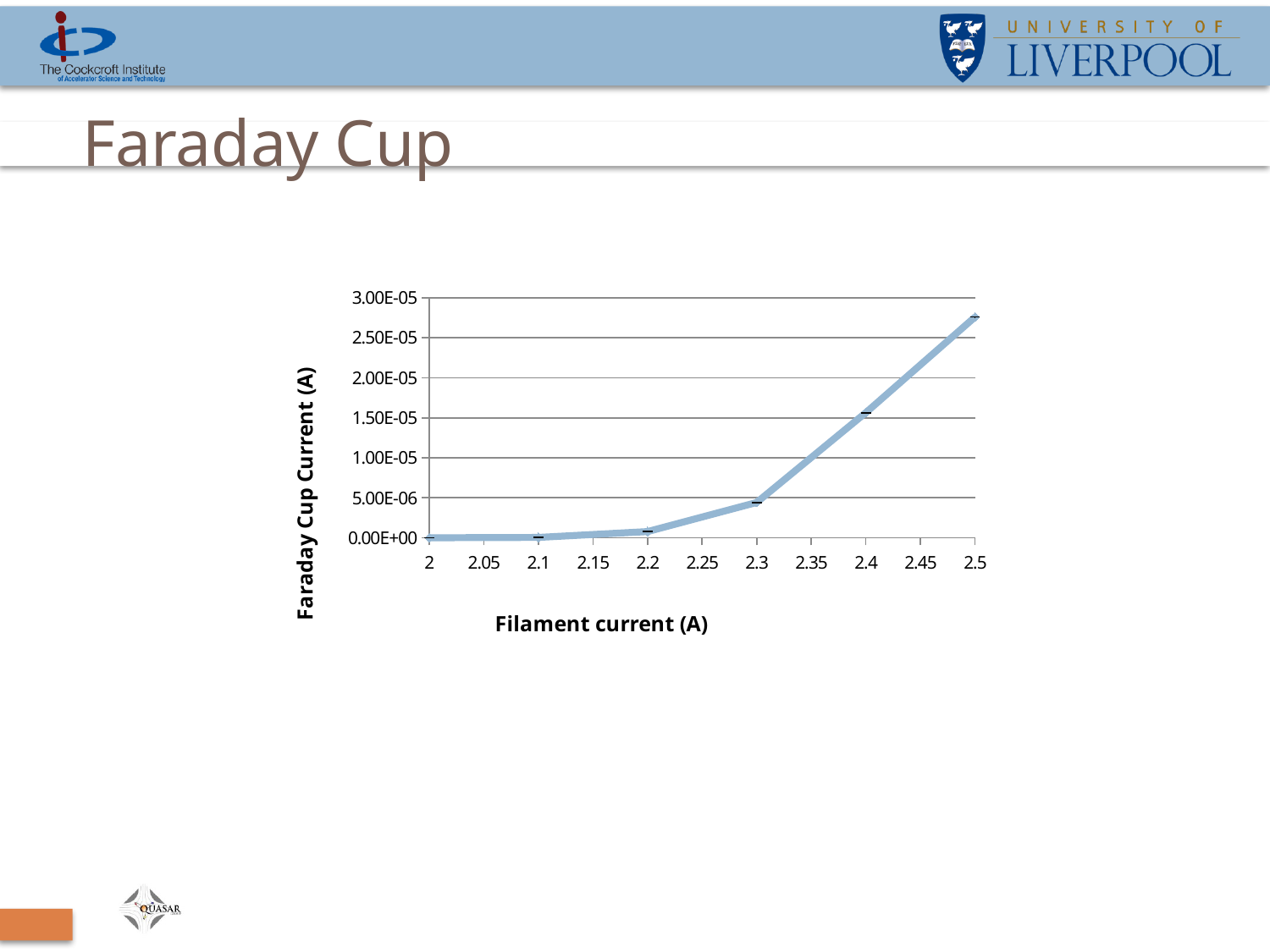
Is the Faraday Cup Current at a filament current of 2.4 A greater or less than 2.00E-05? less How many data points are plotted on the line? 6 What is the label of the y axis? Faraday Cup Current (A) Do the Faraday Cup Current values rise or fall as the filament current increases from 2 A to 2.5 A? rise What is the label of the x axis? Filament current (A) What kind of chart is shown on the slide? line chart At which filament current is the Faraday Cup Current highest? 2.5 Is the Faraday Cup Current at a filament current of 2.4 A greater or less than 1.00E-05? greater Is the Faraday Cup Current at a filament current of 2.5 A greater or less than 2.50E-05? greater Which has the larger Faraday Cup Current: a filament current of 2.3 A or 2.4 A? 2.4